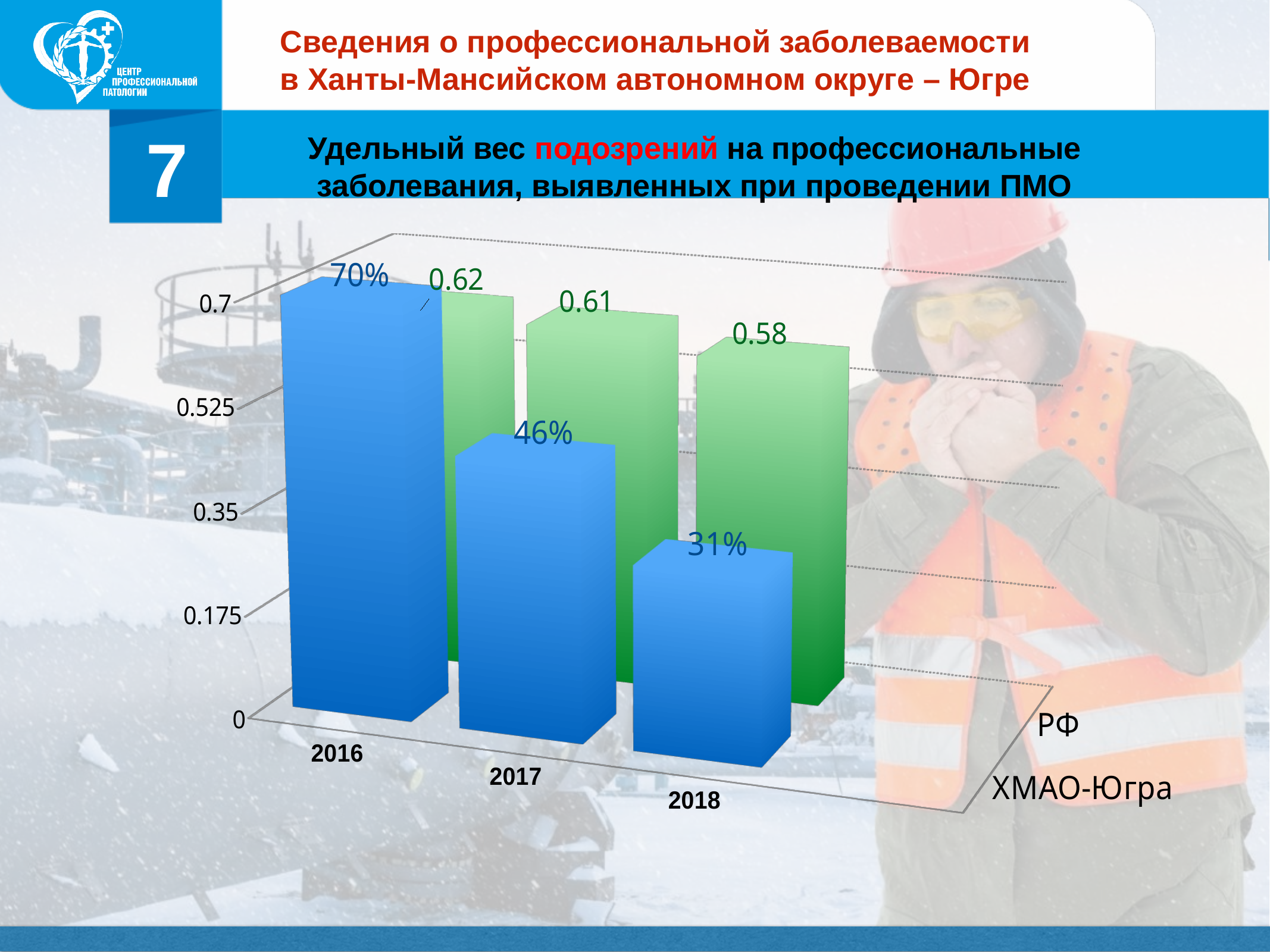
What is the difference between the ХМАО-Югра values for 2016 and 2017? 24% How many years are shown on the x axis? 3 Which is larger: the ХМАО-Югра value for 2017 or for 2018? 2017 What is the value for РФ in 2018? 0.58 What is the value for ХМАО-Югра in 2018? 31% What is the difference between the РФ values for 2016 and 2018? 0.04 What is the value for ХМАО-Югра in 2016? 70% In which year is the РФ value the lowest? 2018 Do the ХМАО-Югра values rise or fall from 2016 to 2018? fall How many data series does the chart show? 2 What is the value for РФ in 2017? 0.61 In which year is the ХМАО-Югра value the highest? 2016